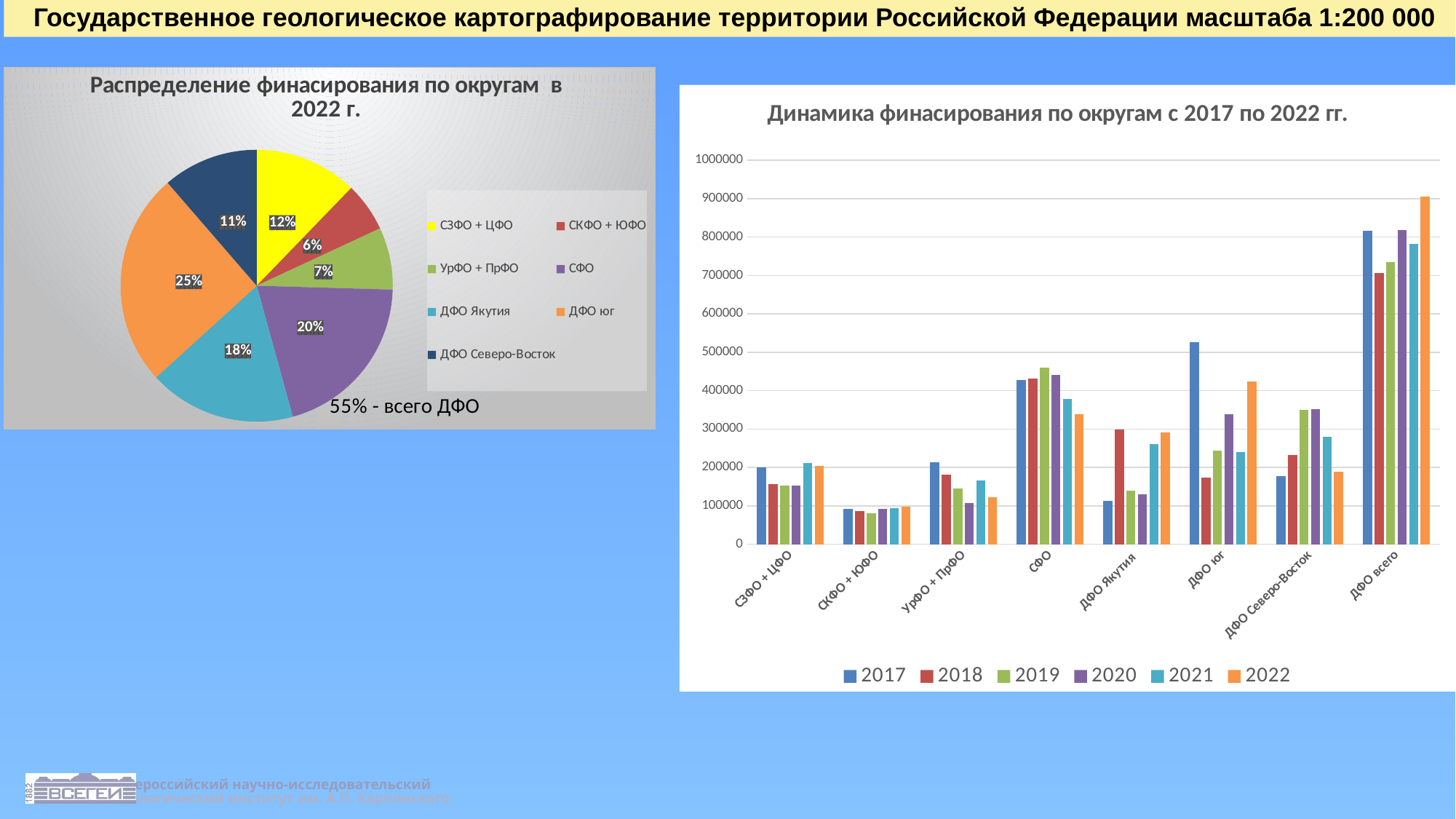
In the pie chart 'Распределение финасирования по округам в 2022 г.', what share does ДФО юг have? 25% In the pie chart 'Распределение финасирования по округам в 2022 г.', what is the difference in percentage points between ДФО Якутия and ДФО Северо-Восток? 7 In the bar chart 'Динамика финасирования по округам с 2017 по 2022 гг.', how many categories are shown on the x axis? 8 In the bar chart 'Динамика финасирования по округам с 2017 по 2022 гг.', which year has the highest value for ДФО всего? 2022 In the pie chart 'Распределение финасирования по округам в 2022 г.', what share does СКФО + ЮФО have? 6% In the pie chart 'Распределение финасирования по округам в 2022 г.', how many slices are there? 7 In the pie chart 'Распределение финасирования по округам в 2022 г.', which category has the smallest share? СКФО + ЮФО What type of chart is 'Динамика финасирования по округам с 2017 по 2022 гг.'? bar chart In the pie chart 'Распределение финасирования по округам в 2022 г.', what share does СФО have? 20% In the bar chart 'Динамика финасирования по округам с 2017 по 2022 гг.', is the 2017 value for ДФО юг greater or less than 500000? greater In the pie chart 'Распределение финасирования по округам в 2022 г.', which category has the largest share? ДФО юг In the bar chart 'Динамика финасирования по округам с 2017 по 2022 гг.', how many series does the legend list? 6